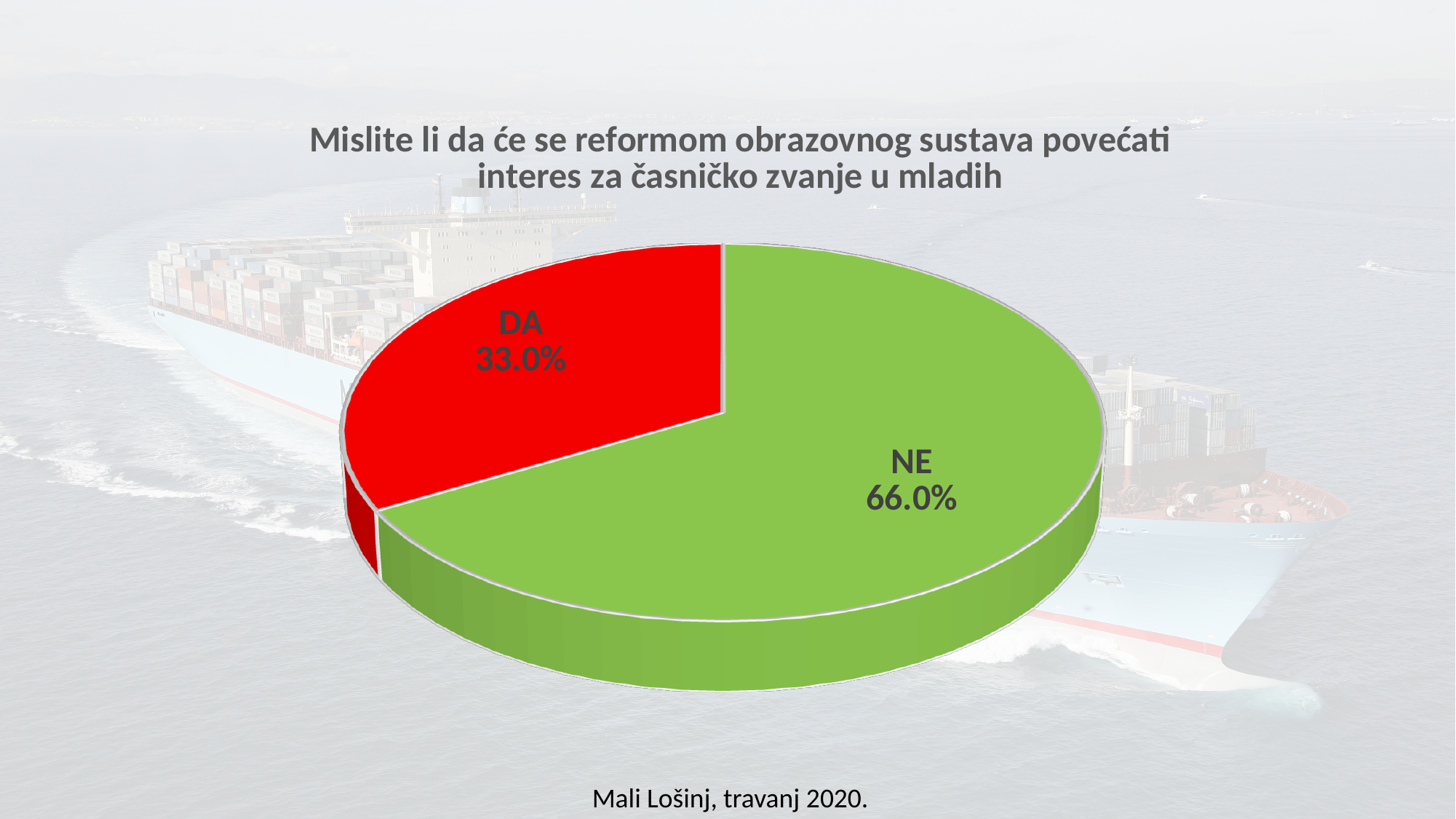
What share of the pie does NE take? 66.0% What is the value for DA? 33.0% What kind of chart is shown on the slide? pie chart Which is larger, DA or NE? NE Which category has the largest share? NE What is the title of the chart? Mislite li da će se reformom obrazovnog sustava povećati interes za časničko zvanje u mladih How many slices does the pie chart have? 2 What colour is the DA slice? red Which category has the smallest share? DA What is the value for NE? 66.0% What is the difference between the NE and DA shares? 33.0%